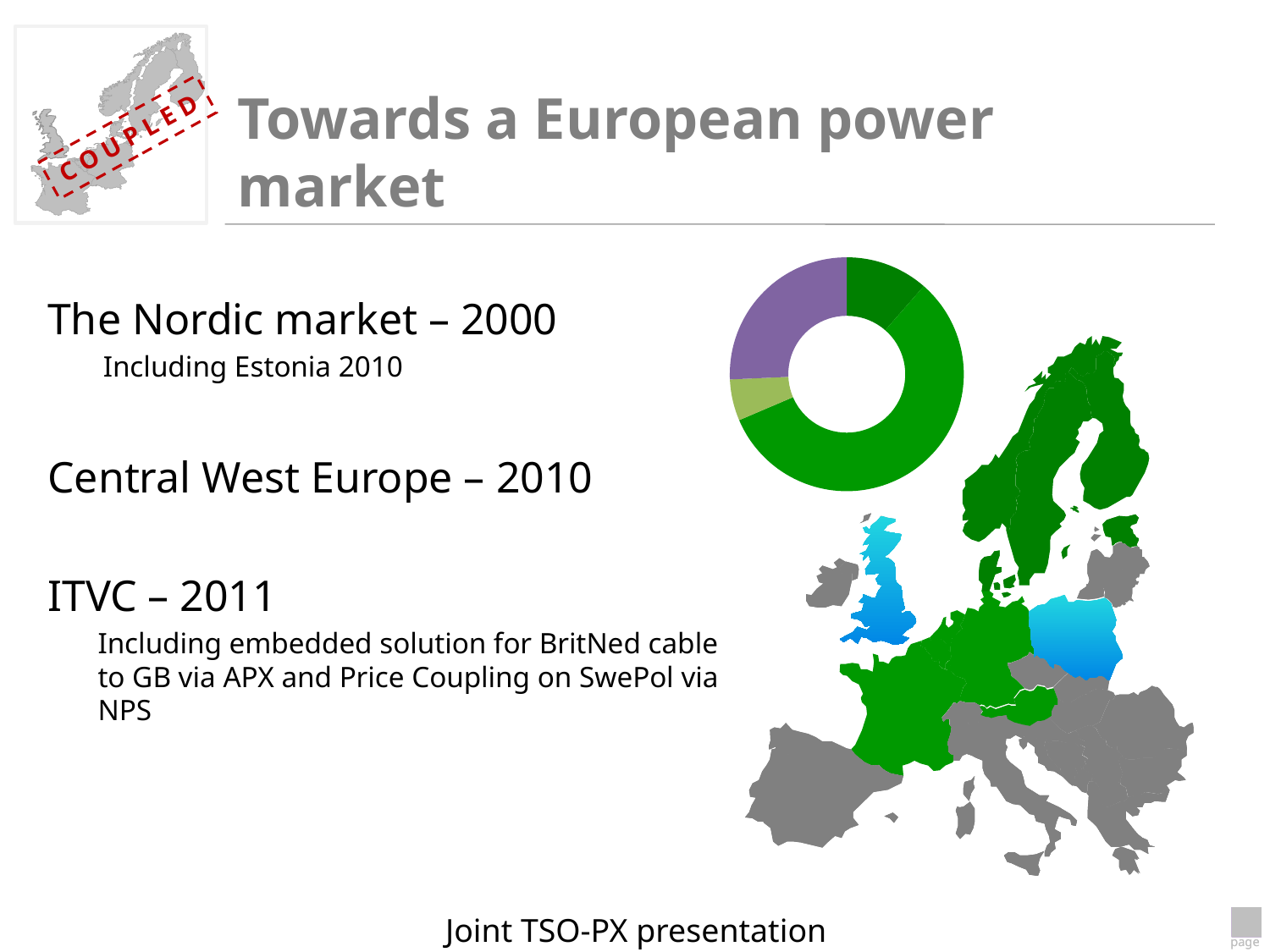
Is the purple slice or the dark green slice larger in the doughnut chart? purple Does the doughnut chart display a legend? No How many slices does the doughnut chart have? 4 Does the doughnut chart show data labels with values on its slices? No What kind of chart is shown on the slide? doughnut chart Is the bright green slice or the purple slice larger in the doughnut chart? bright green Which colour slice is the largest in the doughnut chart? bright green